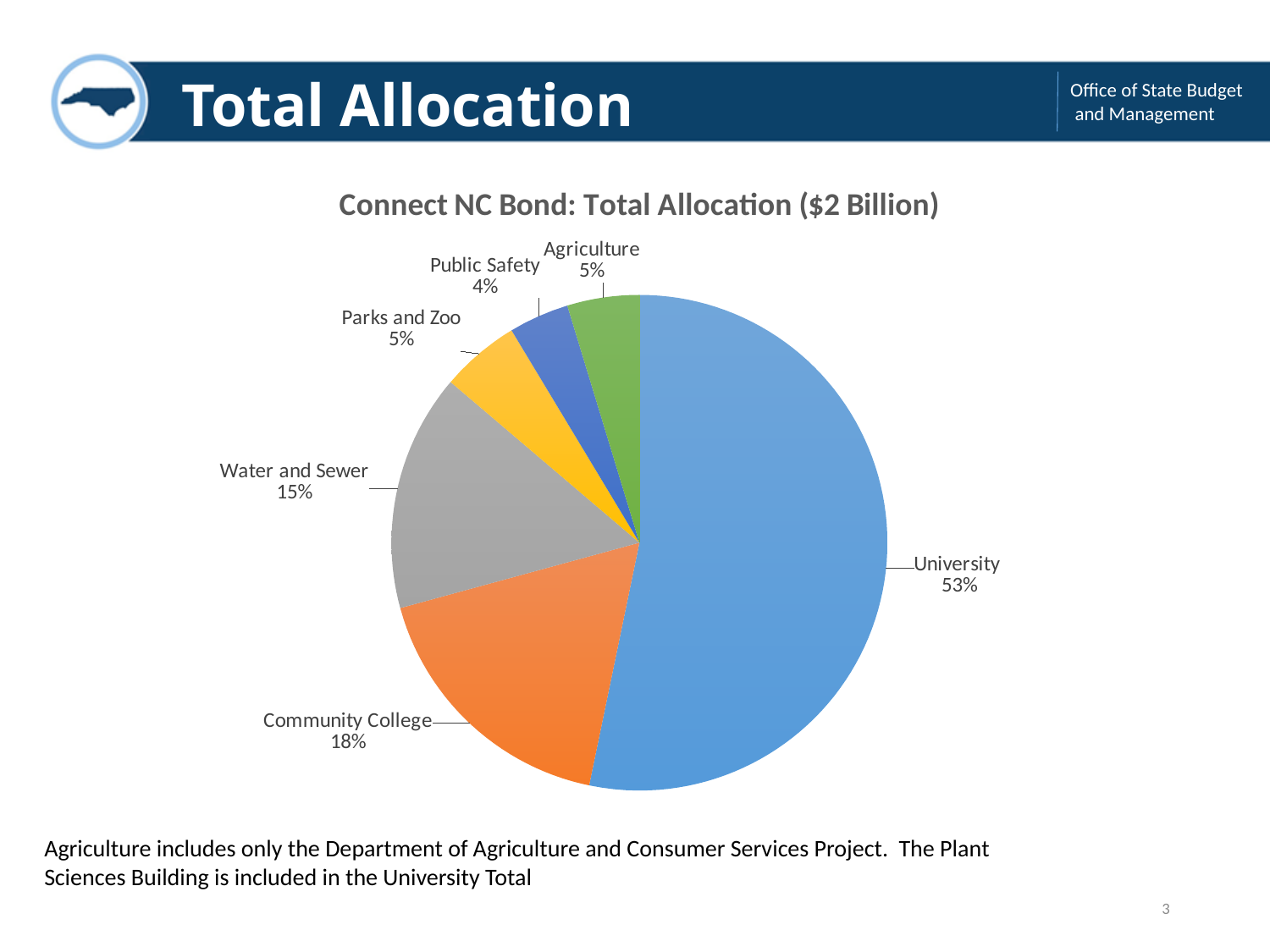
What percentage of the total allocation is for Water and Sewer? 15% How many categories are shown in the pie chart? 6 What kind of chart is shown on the slide? Pie chart What percentage of the total allocation is for Community College? 18% Which is larger: the share for Water and Sewer or the share for Community College? Community College Which category receives the largest share of the total allocation? University What is the title of the chart? Connect NC Bond: Total Allocation ($2 Billion) What share of the Connect NC Bond total allocation goes to University? 53% How many percentage points larger is the University share than the Community College share? 35 What percentage of the total allocation is for Public Safety? 4% Which category receives the smallest share of the total allocation? Public Safety What colour is the University slice of the pie chart? Blue